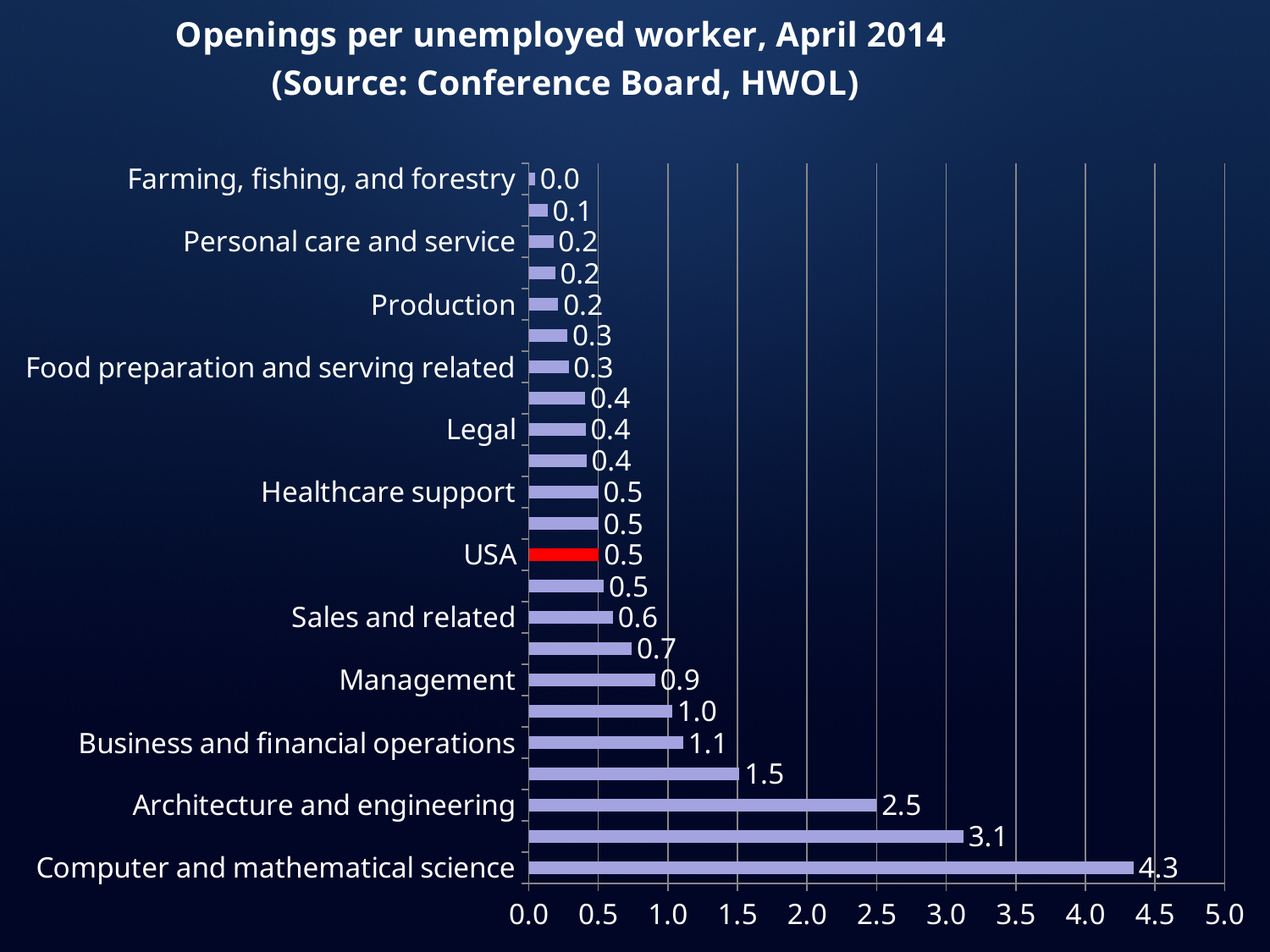
What is the value for Architecture and engineering? 2.5 What is the value for Computer and mathematical science? 4.3 What is the value for USA? 0.5 Is the value for Architecture and engineering greater or less than 2.0? greater Which category has the highest openings per unemployed worker? Computer and mathematical science Which bar is coloured red instead of blue? USA Which category has the lowest openings per unemployed worker? Farming, fishing, and forestry Which is larger, the value for Business and financial operations or the value for Sales and related? Business and financial operations What is the difference between the values for Computer and mathematical science and Architecture and engineering? 1.8 What kind of chart is shown on the slide? Bar chart What is the value for Management? 0.9 How many bars are plotted in the chart? 23